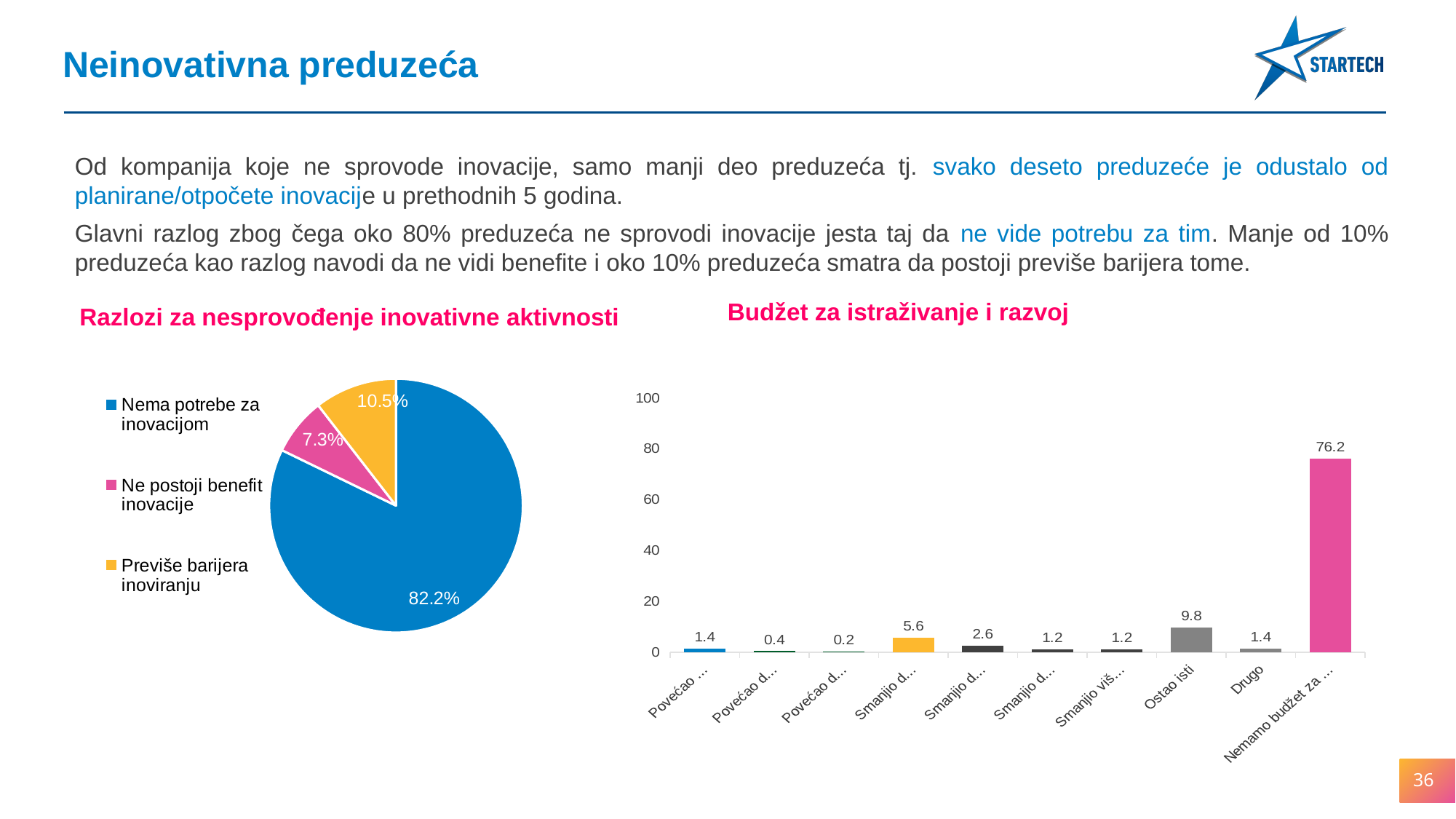
What kind of chart is 'Budžet za istraživanje i razvoj'? Bar chart In the pie chart 'Razlozi za nesprovođenje inovativne aktivnosti', what share is labelled for 'Nema potrebe za inovacijom'? 82.2% In the pie chart 'Razlozi za nesprovođenje inovativne aktivnosti', what share is labelled for 'Ne postoji benefit inovacije'? 7.3% In the pie chart 'Razlozi za nesprovođenje inovativne aktivnosti', which category has the smallest slice? Ne postoji benefit inovacije In the chart 'Budžet za istraživanje i razvoj', how many bars are plotted? 10 In the chart 'Budžet za istraživanje i razvoj', what is the difference between the values for 'Ostao isti' and 'Drugo'? 8.4 In the chart 'Budžet za istraživanje i razvoj', what is the value for 'Drugo'? 1.4 In the chart 'Budžet za istraživanje i razvoj', what is the value for 'Ostao isti'? 9.8 In the pie chart 'Razlozi za nesprovođenje inovativne aktivnosti', how many categories does the legend list? 3 In the pie chart 'Razlozi za nesprovođenje inovativne aktivnosti', which is larger: 'Previše barijera inoviranju' or 'Ne postoji benefit inovacije'? Previše barijera inoviranju In the chart 'Budžet za istraživanje i razvoj', what is the highest value shown? 76.2 In the pie chart 'Razlozi za nesprovođenje inovativne aktivnosti', what share is labelled for 'Previše barijera inoviranju'? 10.5%